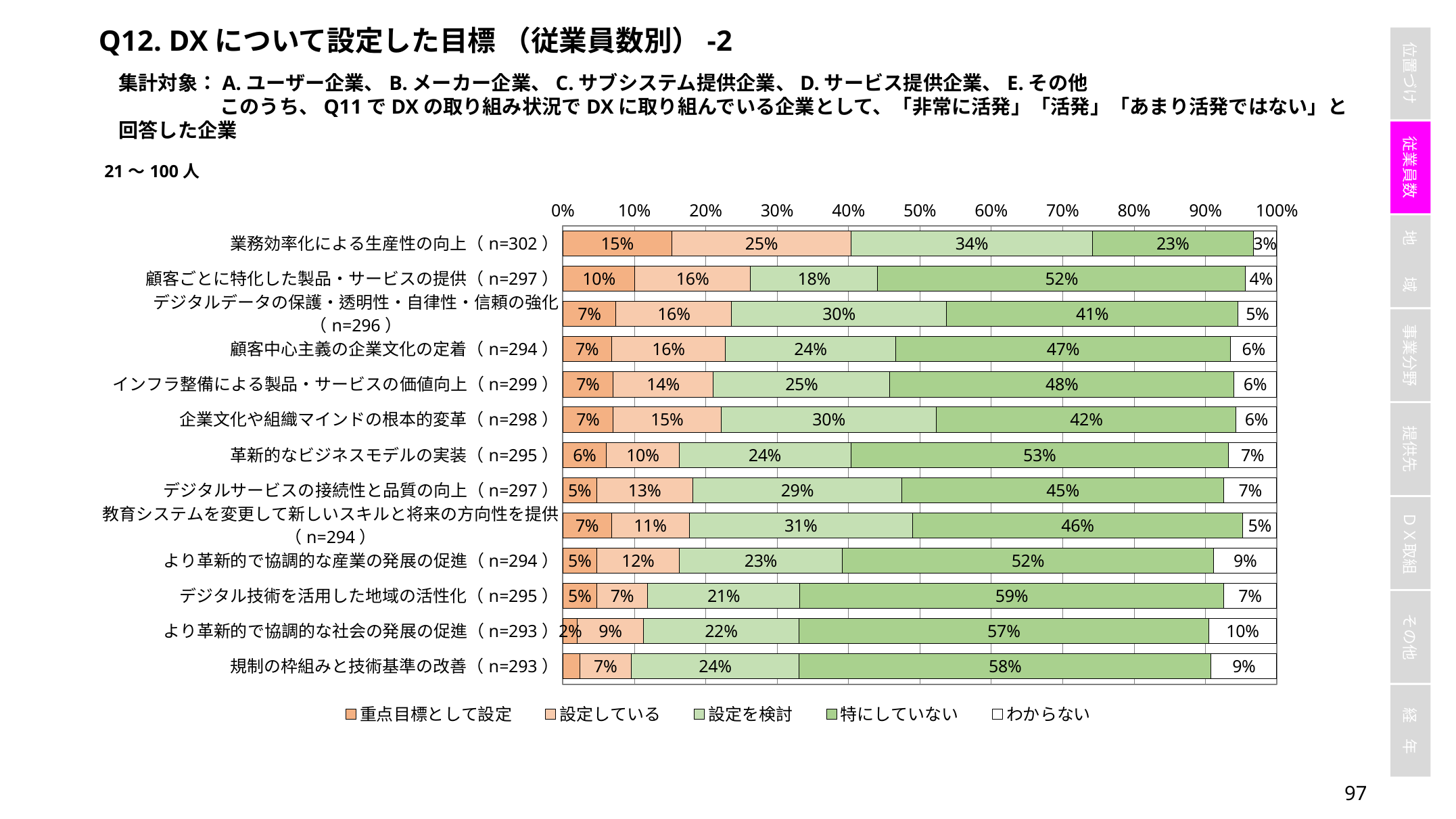
What kind of chart is shown on the slide? Stacked bar chart Which is larger: the 設定している value for 業務効率化による生産性の向上 or for 顧客ごとに特化した製品・サービスの提供? 業務効率化による生産性の向上 How many series does the legend list? 5 What is the value of 特にしていない for デジタル技術を活用した地域の活性化? 59% Which category has the highest value for 重点目標として設定? 業務効率化による生産性の向上 What is the value of 重点目標として設定 for 業務効率化による生産性の向上? 15% How many categories (goals) are plotted in the chart? 13 Which category has the highest value for 特にしていない? デジタル技術を活用した地域の活性化 What is the value of 設定を検討 for 教育システムを変更して新しいスキルと将来の方向性を提供? 31% What is the difference between the 特にしていない values for 革新的なビジネスモデルの実装 and 業務効率化による生産性の向上? 30% Which category has the lowest value for わからない? 業務効率化による生産性の向上 What is the value of わからない for より革新的で協調的な社会の発展の促進? 10%